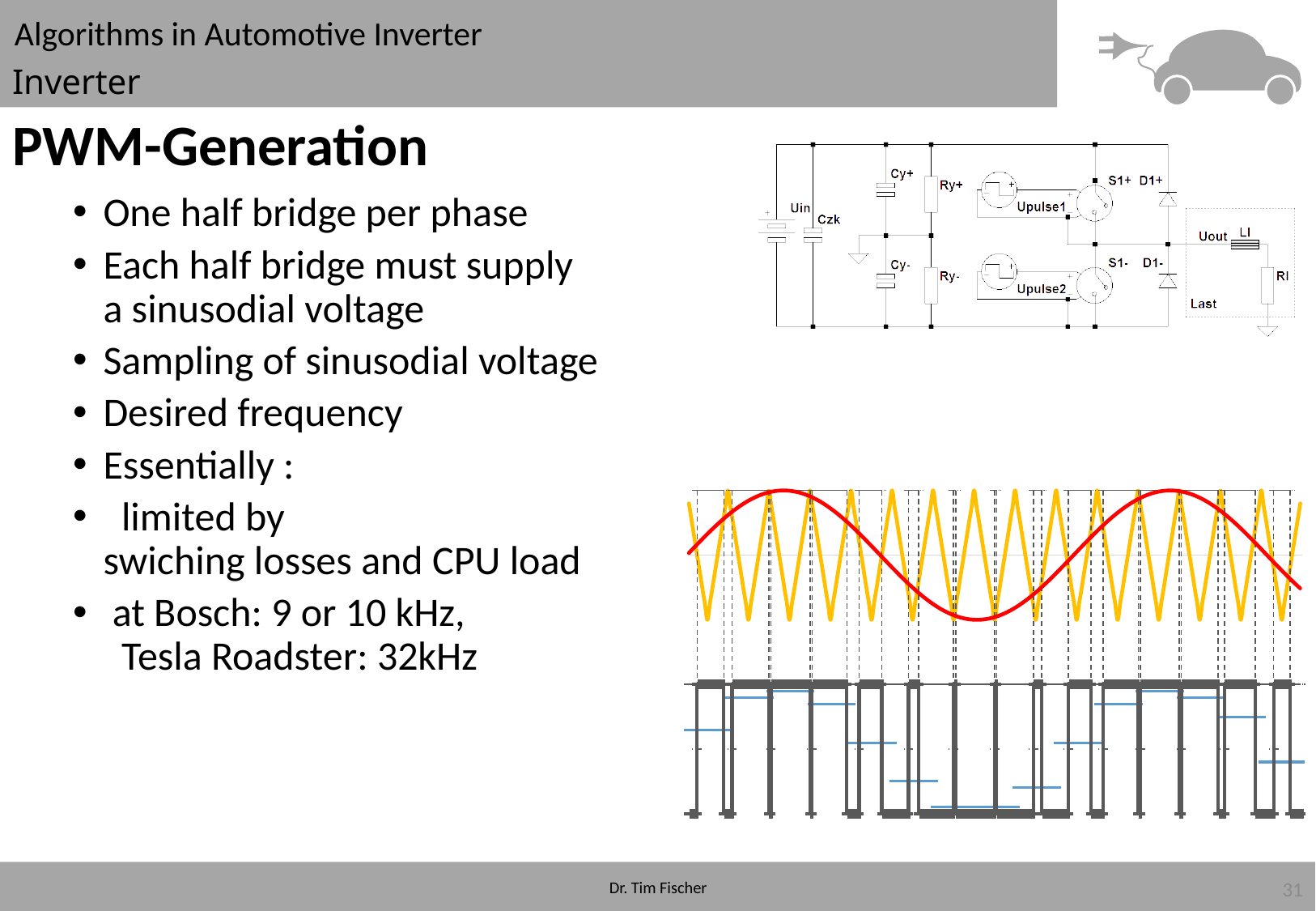
In the waveform plot in the lower right, is the red sinusoidal curve rising or falling at the left edge of the plot? rising In the waveform plot in the lower right, what colour is the smooth sinusoidal curve? red In the waveform plot in the lower right, what colour is the triangular carrier waveform? yellow What kind of chart is the waveform plot in the lower right of the slide? line chart